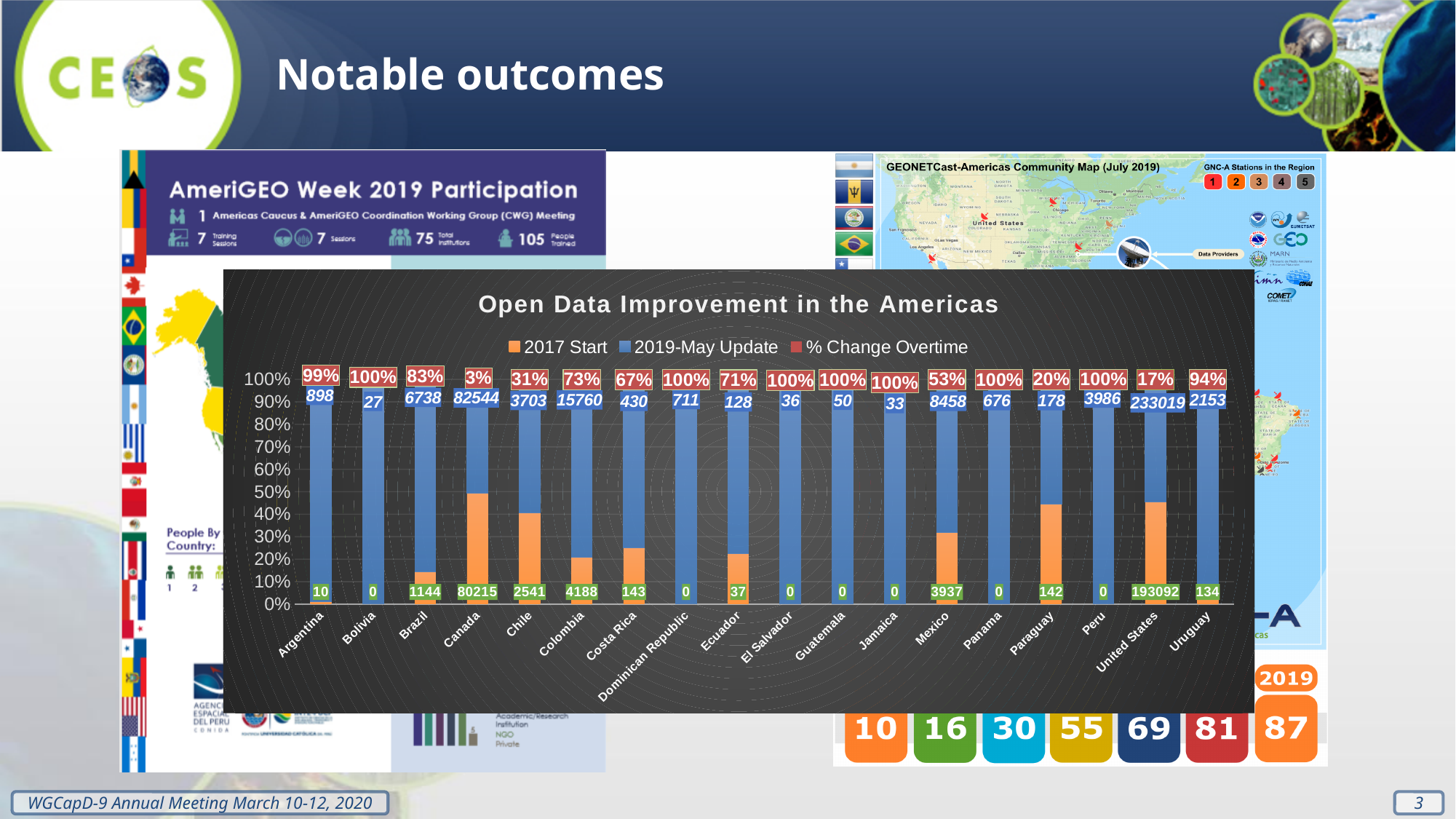
Which country has the highest 2019-May Update value in the Open Data Improvement in the Americas chart? United States What is the 2017 Start value for Mexico in the Open Data Improvement in the Americas chart? 3937 Which country has the lowest % Change Overtime in the Open Data Improvement in the Americas chart? Canada What is the difference between the 2019-May Update and 2017 Start values for Chile in the Open Data Improvement in the Americas chart? 1162 How many series does the legend of the Open Data Improvement in the Americas chart list? 3 How many countries are shown on the x axis of the Open Data Improvement in the Americas chart? 18 Which is larger in the Open Data Improvement in the Americas chart: the 2019-May Update value for Peru or for Chile? Peru What kind of chart is the Open Data Improvement in the Americas chart? Stacked bar chart What is the 2017 Start value for the United States in the Open Data Improvement in the Americas chart? 193092 What is the title of the chart on the slide? Open Data Improvement in the Americas What is the % Change Overtime shown for Brazil in the Open Data Improvement in the Americas chart? 83% What is the 2019-May Update value for Colombia in the Open Data Improvement in the Americas chart? 15760